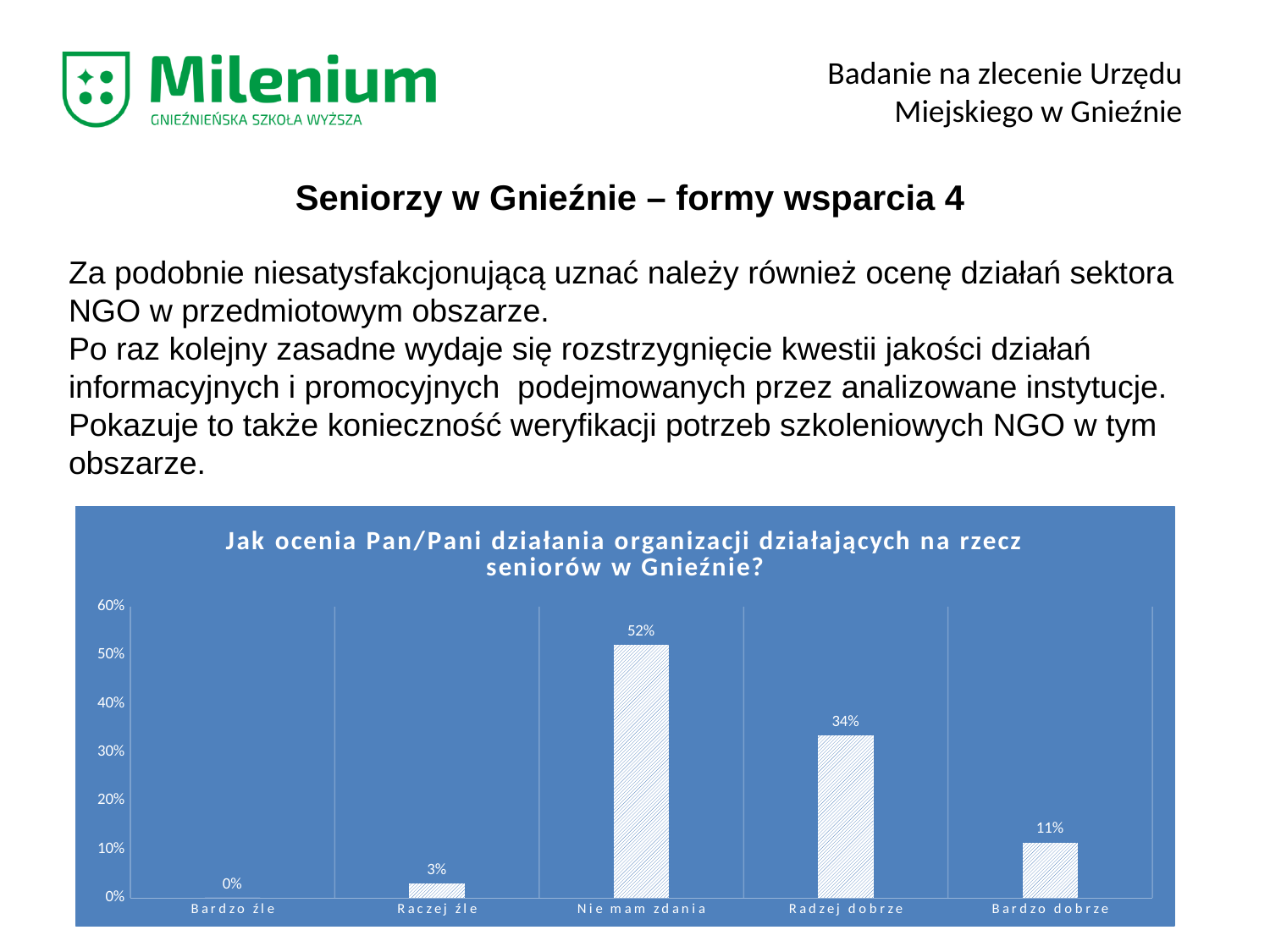
Which category has the highest value? Nie mam zdania What is the value for "Bardzo dobrze"? 11% Is the value for "Nie mam zdania" greater or less than 50%? greater What is the difference between the values for "Nie mam zdania" and "Radzej dobrze"? 18% Which is larger, the value for "Radzej dobrze" or the value for "Bardzo dobrze"? Radzej dobrze What kind of chart is shown on the slide? bar chart What is the title of the chart? Jak ocenia Pan/Pani działania organizacji działających na rzecz seniorów w Gnieźnie? What is the value for "Raczej źle"? 3% How many categories are shown on the x axis? 5 Which category has the lowest value? Bardzo źle What is the value for "Radzej dobrze"? 34% What is the value for "Nie mam zdania"? 52%